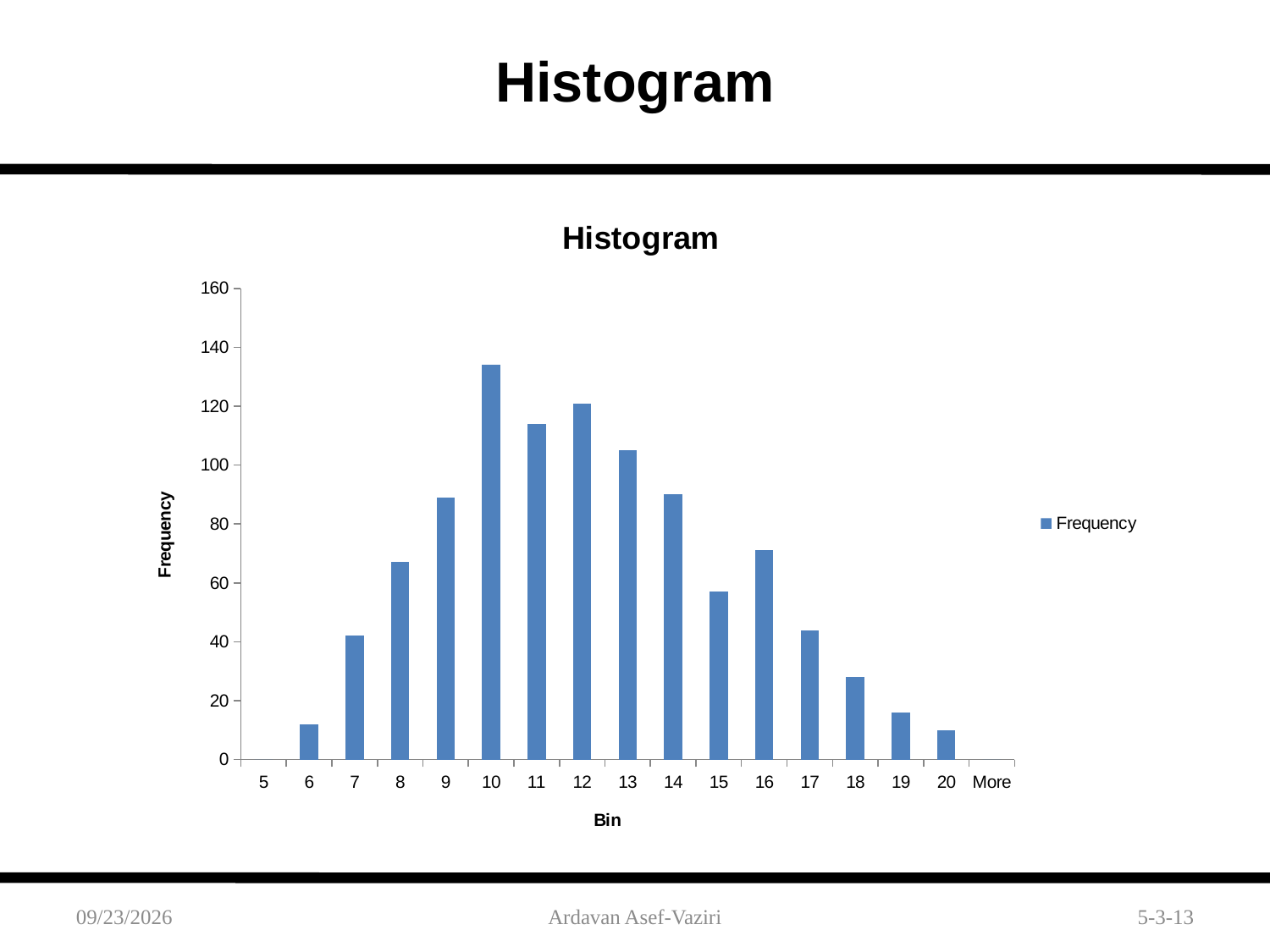
Which bin has the higher frequency, bin 10 or bin 12? 10 Is the frequency for bin 10 greater or less than 120? greater What is the label on the horizontal axis? Bin Which bin has the highest frequency? 10 Is the frequency for bin 16 greater or less than 60? greater Do the frequencies rise or fall from bin 10 to bin 20? fall Is the frequency for bin 14 greater or less than 80? greater What kind of chart is shown on the slide? bar chart Which bin has the higher frequency, bin 15 or bin 16? 16 How many series does the legend list? 1